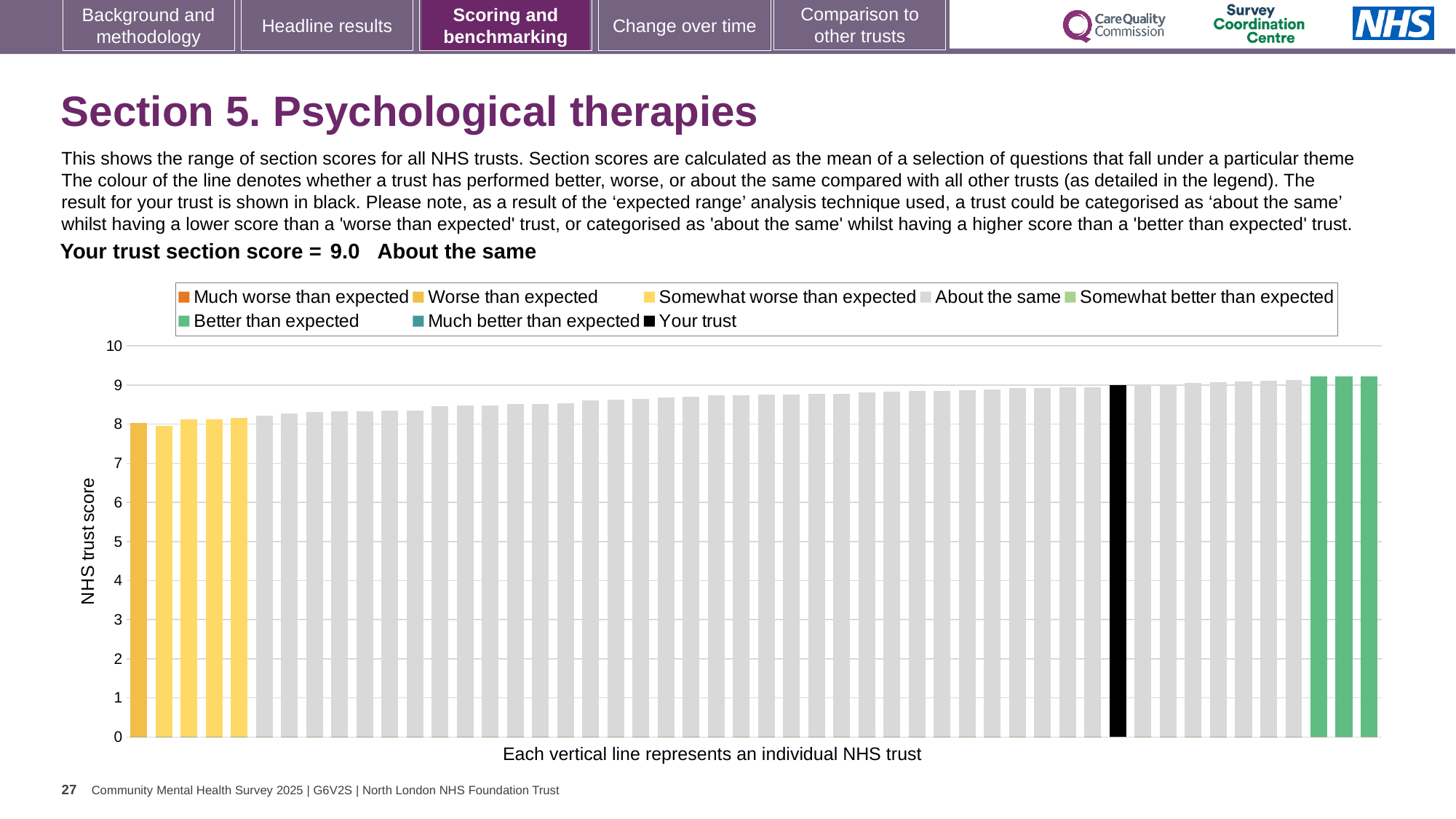
What is the section score for your trust shown on the slide? 9.0 Is the value of the leftmost bar greater or less than 9? less Is the value for your trust (the black bar) greater or less than 8? greater How many entries does the chart legend list? 8 How many bars are coloured green (Better than expected)? 3 What is the label on the vertical axis of the chart? NHS trust score Is the black bar for your trust higher or lower than the leftmost bar? higher Which category is your trust placed in according to the text above the chart? About the same Are the values of the green bars at the right of the chart greater or less than 8? greater What kind of chart is shown on the slide? bar chart How many bars are coloured yellow (worse or somewhat worse than expected)? 5 Do the bar values rise or fall from left to right across the chart? rise